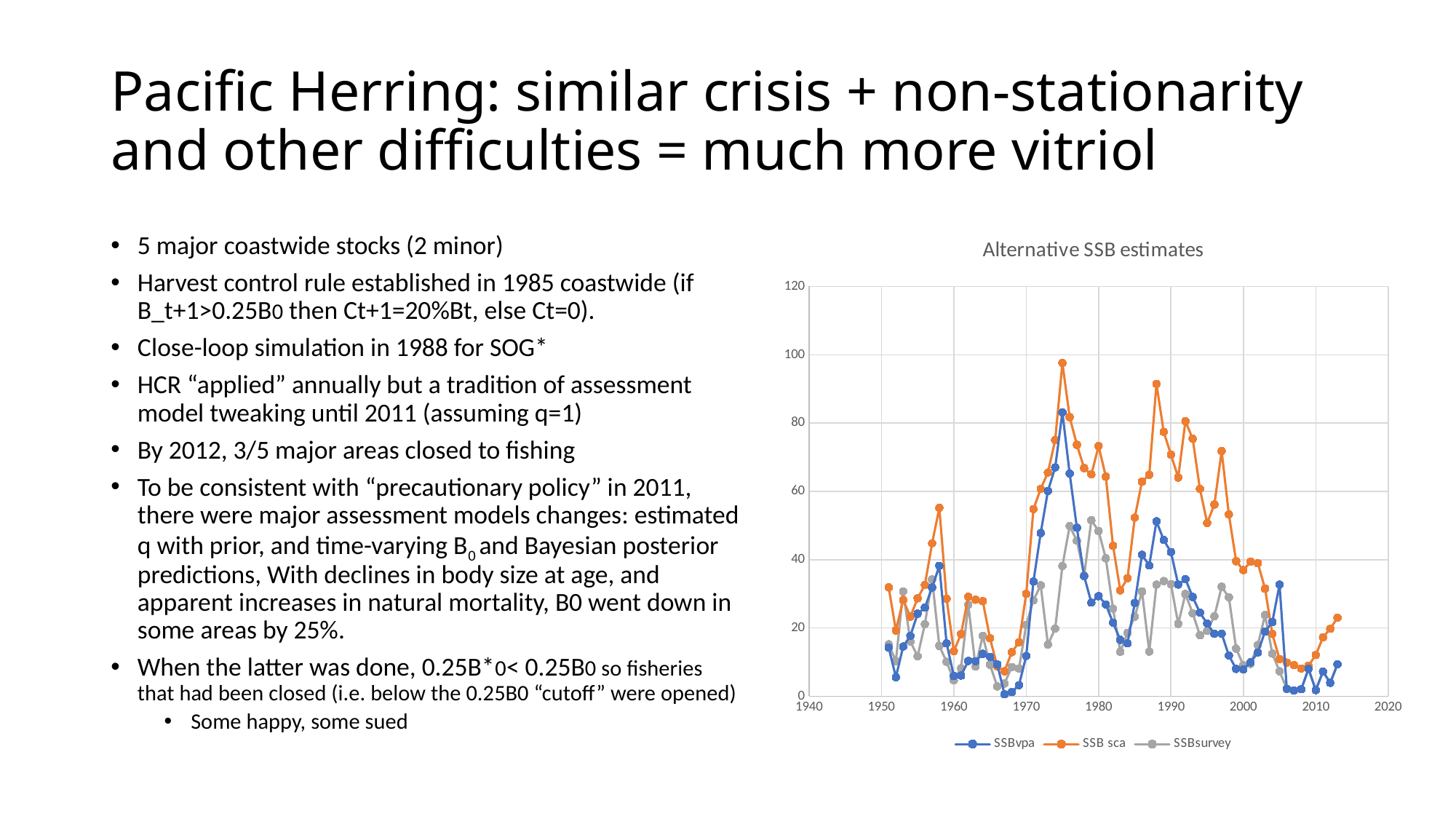
Is the highest value of the SSBsurvey series greater or less than 60? less Does the SSBvpa series rise or fall between 1975 and 1983? fall Which series reaches the highest value anywhere in the chart? SSB sca Is the value of the SSB sca series around 1988 greater or less than 80? greater What kind of chart is shown on the slide? line chart How many series does the legend of the chart list? 3 Around 1975, which is larger: the SSB sca value or the SSBsurvey value? SSB sca Is the peak value of the SSB sca series around 1975 greater or less than 80? greater What is the title of the chart? Alternative SSB estimates Around 1990, which series has the lowest value? SSBsurvey Which series is drawn in orange in the chart? SSB sca